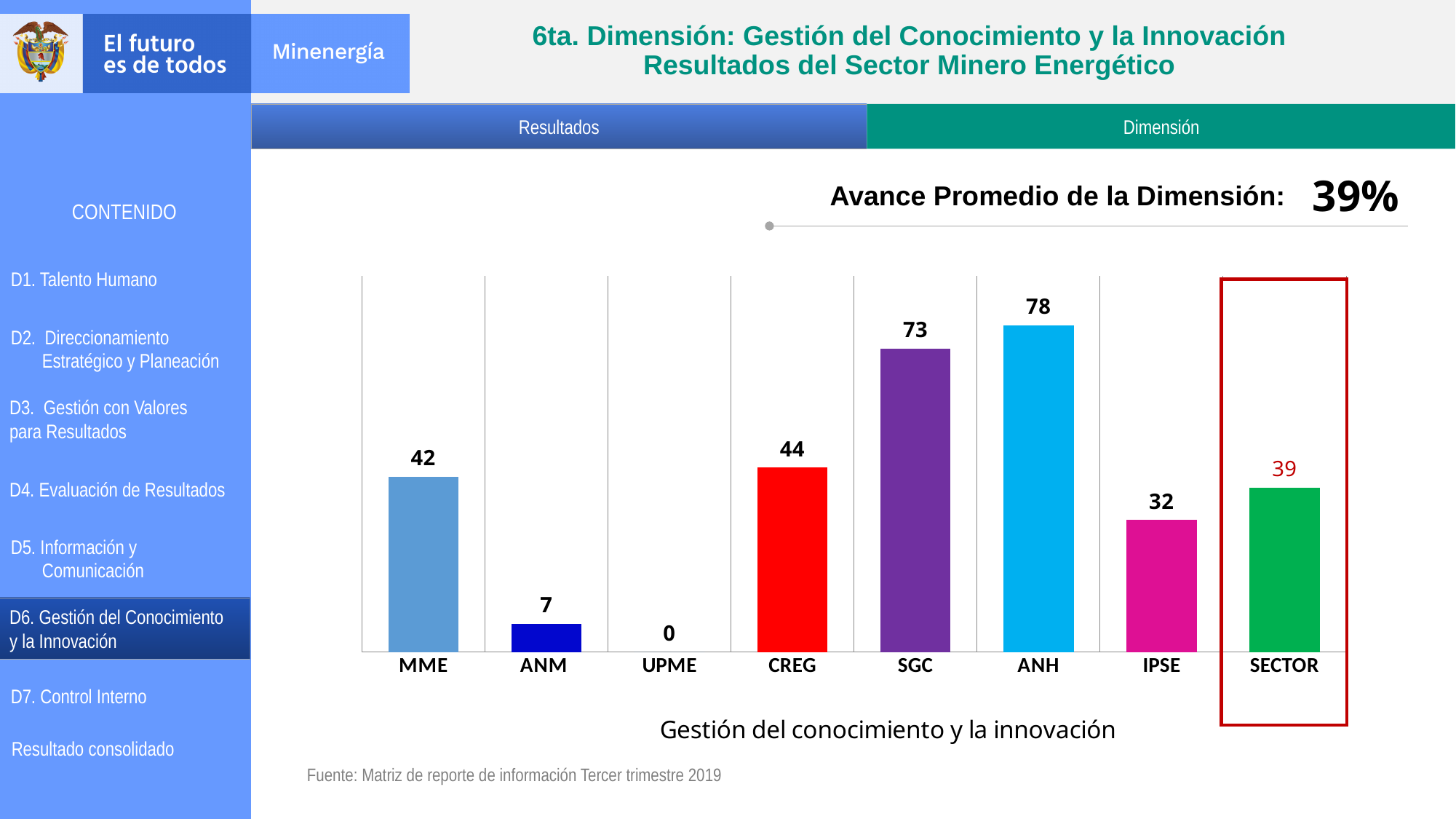
Which category's bar is highlighted with a red box? SECTOR Which is larger, the value for MME or the value for CREG? CREG Which category has the highest value? ANH What is the difference between the values for ANH and ANM? 71 What is the title shown below the chart? Gestión del conocimiento y la innovación How many categories are shown on the x axis? 8 What kind of chart is shown? Bar chart What is the value for UPME? 0 What is the value for SECTOR? 39 What is the value for ANH? 78 Which category has the lowest value? UPME What is the difference between the values for SGC and IPSE? 41